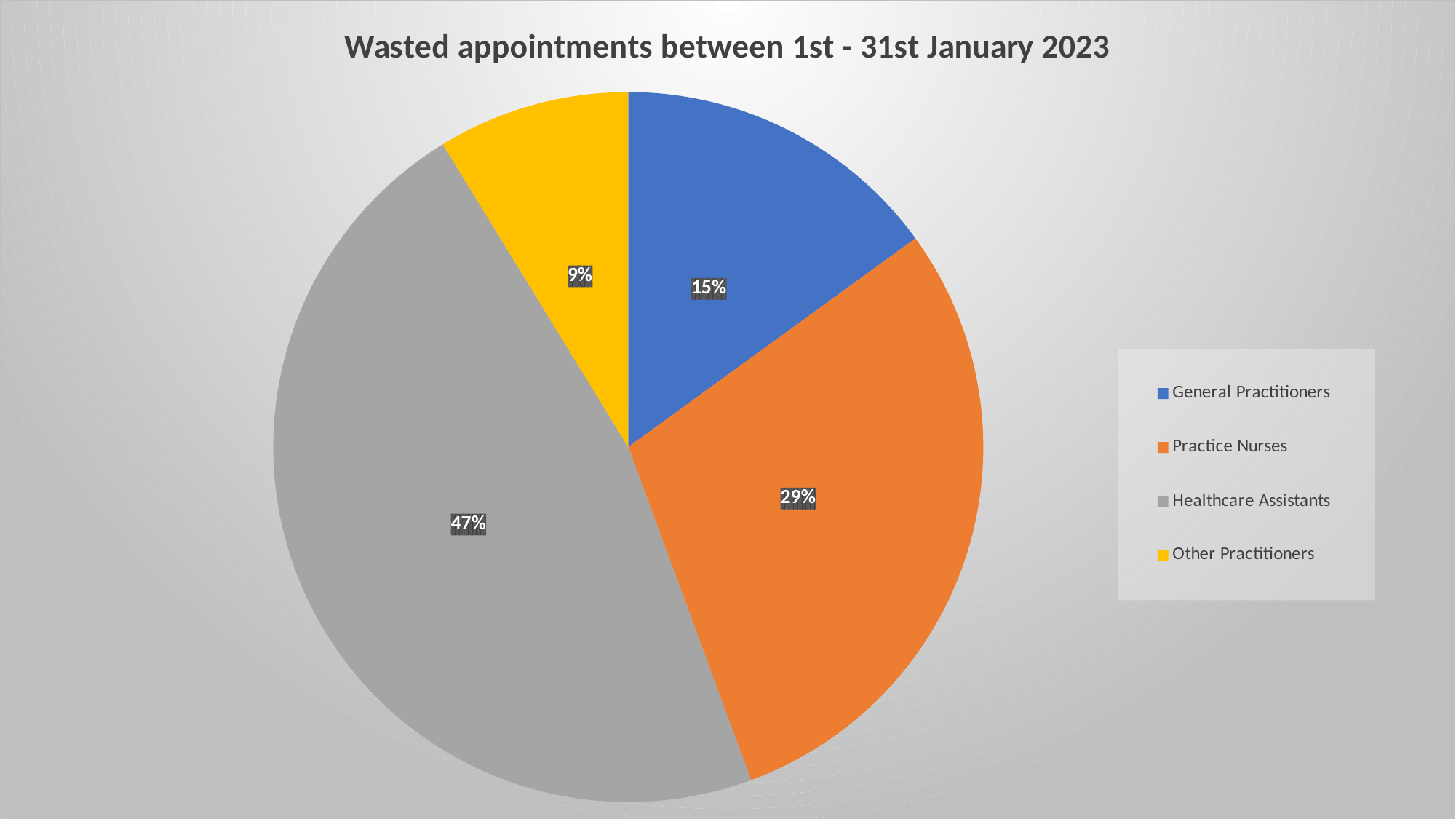
Which category has the smallest slice of the pie? Other Practitioners What is the title of the chart? Wasted appointments between 1st - 31st January 2023 Which category has the largest slice of the pie? Healthcare Assistants What share of wasted appointments is attributed to General Practitioners? 15% What share of wasted appointments is attributed to Healthcare Assistants? 47% What share of wasted appointments is attributed to Practice Nurses? 29% What type of chart is shown on the slide? pie chart What colour is the slice for Practice Nurses? orange Which is larger, the share for General Practitioners or the share for Other Practitioners? General Practitioners What is the difference in percentage points between Healthcare Assistants and Practice Nurses? 18 How many categories does the pie chart show? 4